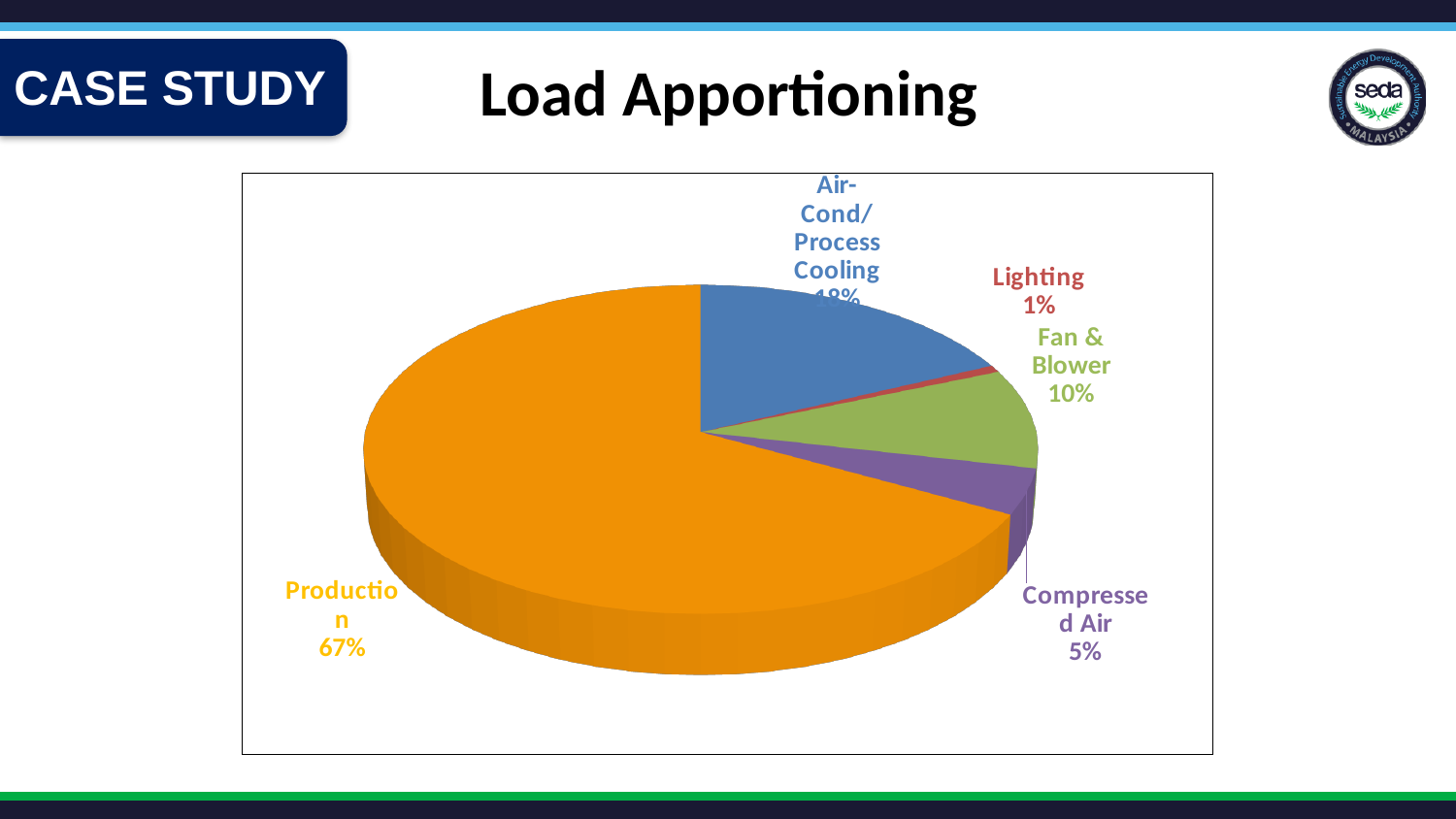
What colour is the Production slice of the pie? Orange How many percentage points larger is Production's share than Fan & Blower's share? 57 percentage points What percentage of the load is Lighting? 1% Which category has the largest share of the pie? Production What share of the load does Production account for? 67% How many categories are shown in the pie chart? 5 Which category has the smallest share of the pie? Lighting What percentage of the load is Fan & Blower? 10% Which has a larger share, Fan & Blower or Compressed Air? Fan & Blower What percentage of the load is Compressed Air? 5% What is the title of the slide containing the chart? Load Apportioning What kind of chart is shown on the slide? Pie chart